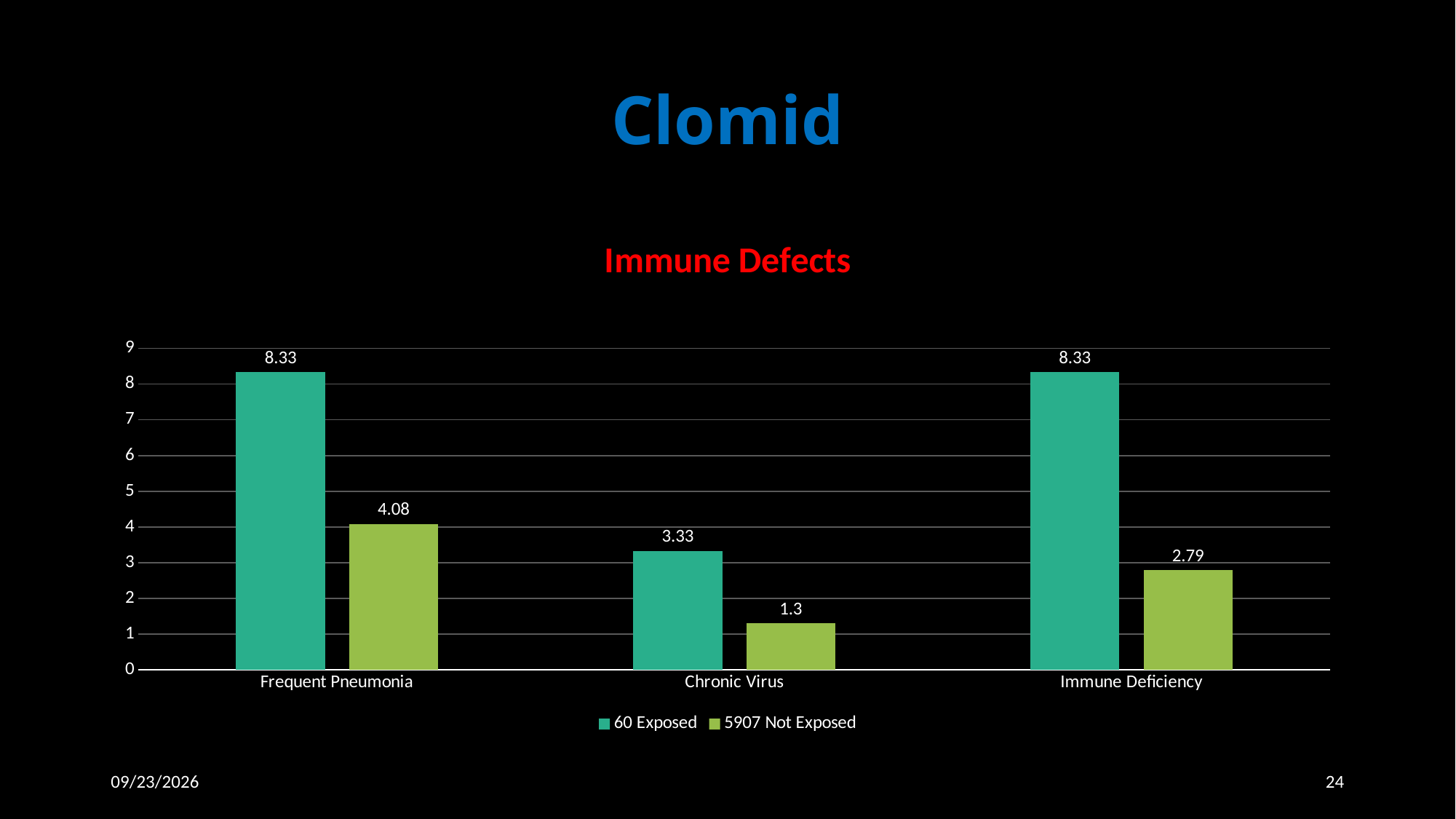
How many series does the legend list? 2 What is the value for 5907 Not Exposed in the Immune Deficiency category? 2.79 Which is larger for Chronic Virus: the 60 Exposed value or the 5907 Not Exposed value? 60 Exposed What is the value for 5907 Not Exposed in the Chronic Virus category? 1.3 What is the value for 60 Exposed in the Frequent Pneumonia category? 8.33 What is the difference between the 60 Exposed and 5907 Not Exposed values for Frequent Pneumonia? 4.25 What is the difference between the 60 Exposed and 5907 Not Exposed values for Immune Deficiency? 5.54 Which category has the lowest value for the 60 Exposed series? Chronic Virus What is the value for 60 Exposed in the Chronic Virus category? 3.33 What is the title of the chart? Immune Defects Which category has the highest value for the 5907 Not Exposed series? Frequent Pneumonia How many categories are shown on the x axis of the chart? 3